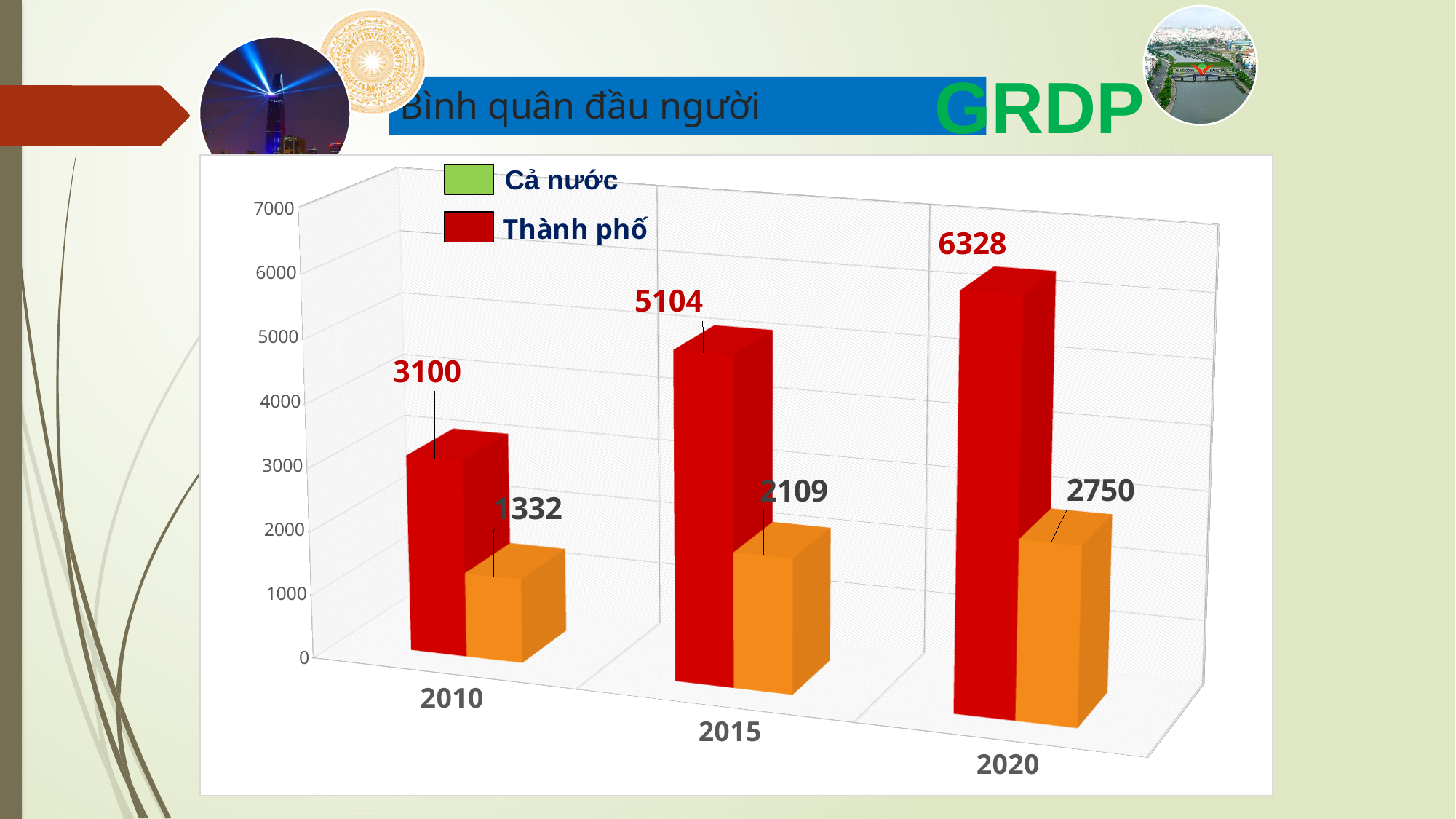
How many series does the legend list? 2 What is the value for Thành phố in 2020? 6328 What kind of chart is shown on the slide? Bar chart What is the difference between the Thành phố and Cả nước values in 2015? 2995 In which year is the Cả nước value lowest? 2010 In which year is the Thành phố value highest? 2020 How many years are shown on the x axis? 3 What is the value for Cả nước in 2020? 2750 What is the value for Thành phố in 2015? 5104 Do the Cả nước values rise or fall from 2010 to 2020? Rise Which is larger in 2010, the Thành phố value or the Cả nước value? Thành phố What is the value for Cả nước in 2010? 1332